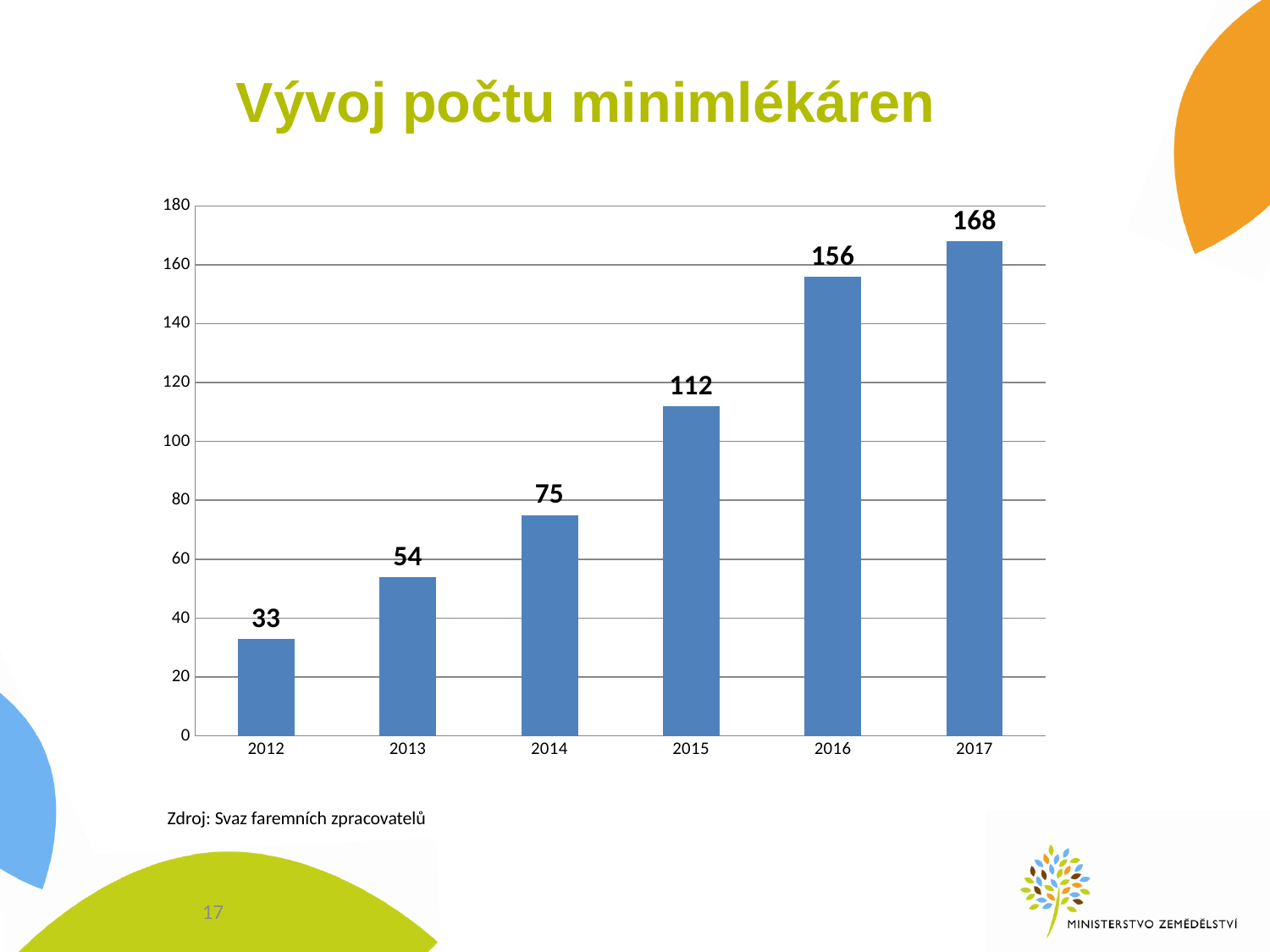
What is the value for 2017? 168 What is the value for 2012? 33 Which is larger, the value for 2013 or the value for 2014? 2014 Which year has the highest value? 2017 What is the difference between the values for 2016 and 2015? 44 What kind of chart is shown on the slide? bar chart Which year has the lowest value? 2012 What is the value for 2015? 112 How many years are shown on the x axis? 6 Is the value for 2016 greater or less than 140? greater What is the difference between the values for 2017 and 2012? 135 Do the values rise or fall from 2012 to 2017? rise